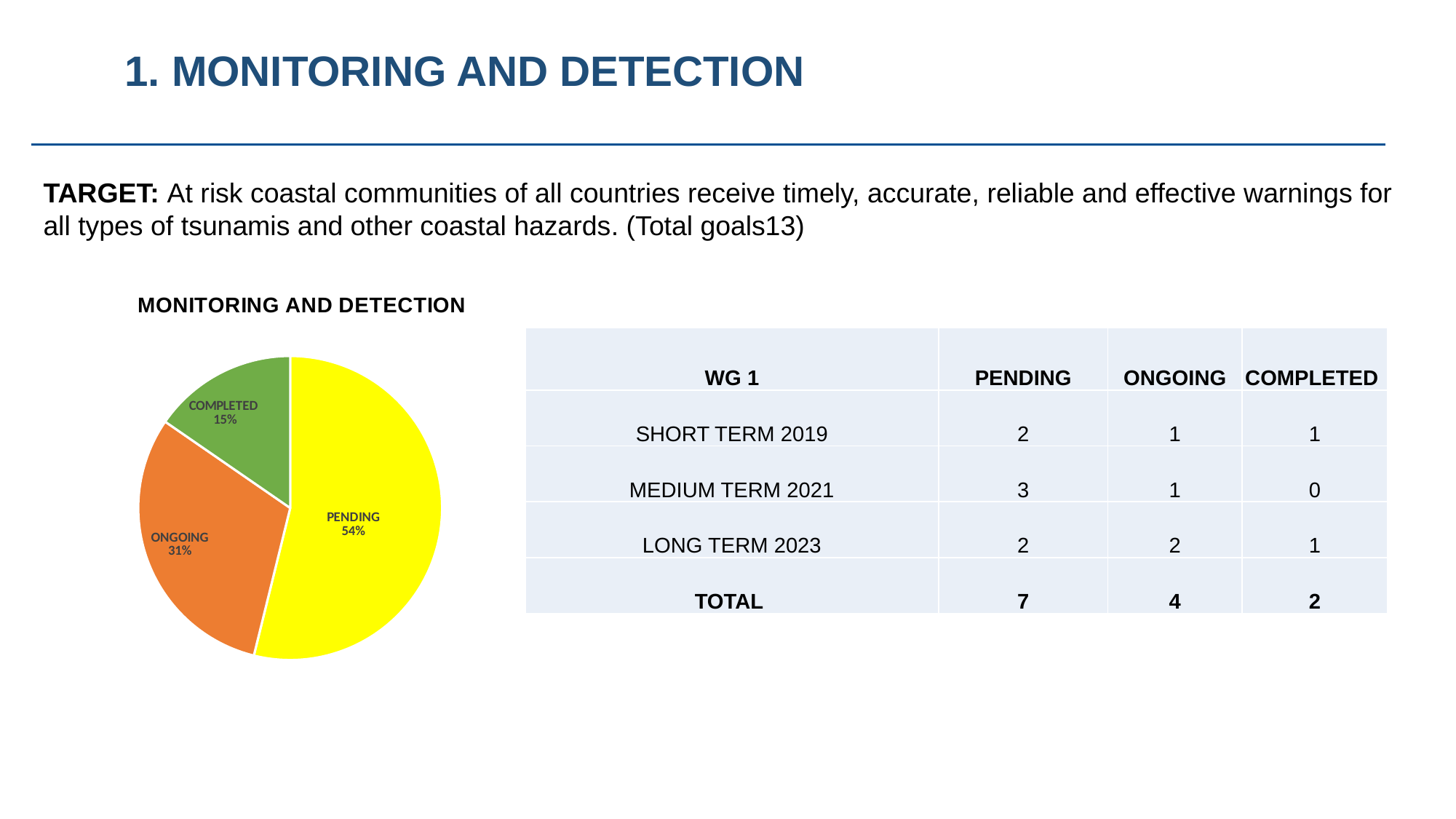
How many slices does the pie chart have? 3 What share of the pie does PENDING represent? 54% What share of the pie does ONGOING represent? 31% Which slice of the pie is the smallest? COMPLETED Which slice of the pie is the largest? PENDING What type of chart is shown on the slide? pie chart What colour is the PENDING slice? yellow What is the difference in percentage points between the PENDING and ONGOING slices? 23 Which slice is larger, ONGOING or COMPLETED? ONGOING What share of the pie does COMPLETED represent? 15% What is the title of the chart? MONITORING AND DETECTION Is the share for ONGOING greater or less than 50%? less